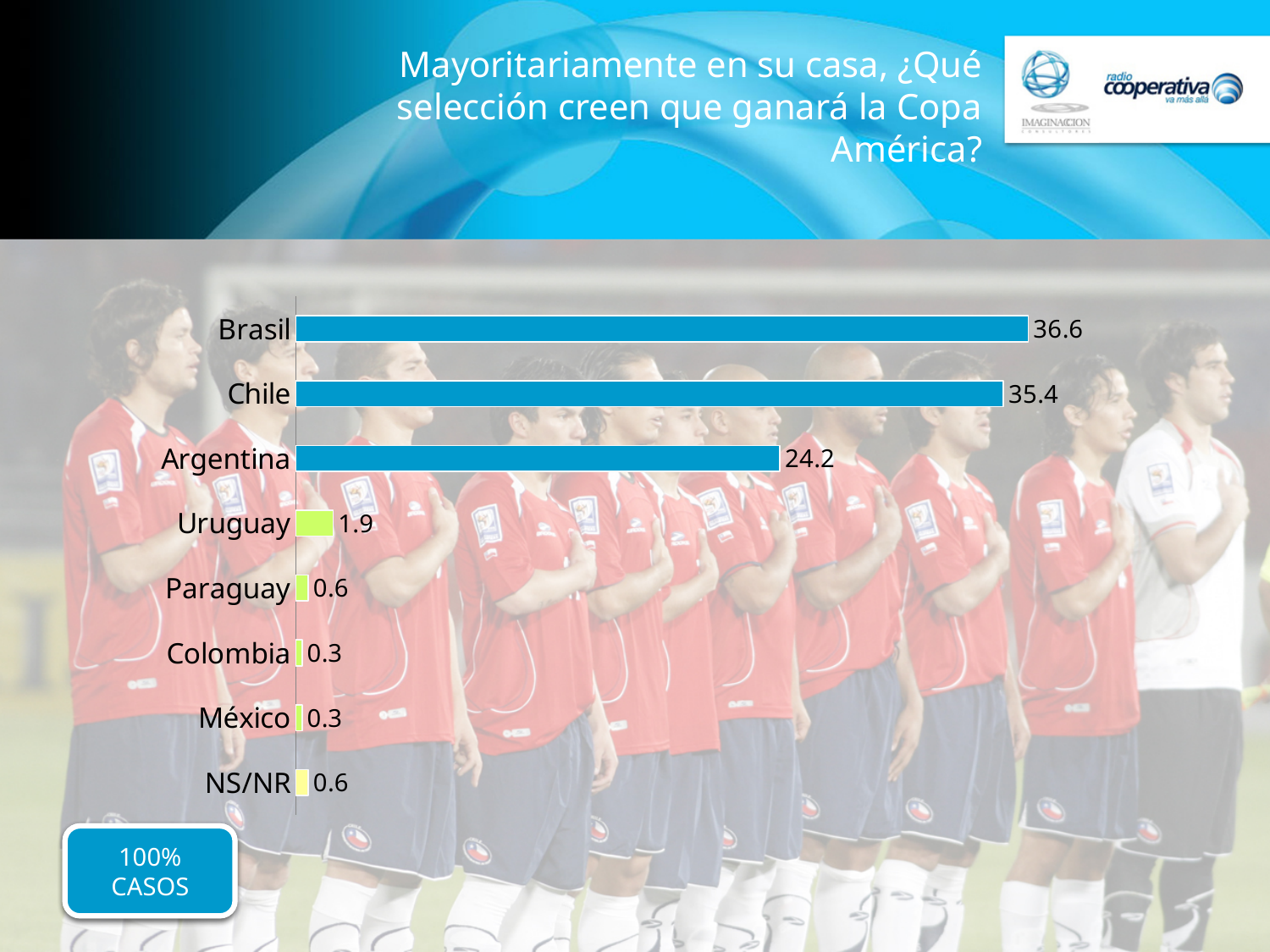
What is the difference between the values for Brasil and Chile? 1.2 What is the value for Paraguay? 0.6 What is the value for NS/NR? 0.6 Which is larger, the value for Argentina or the value for Uruguay? Argentina What kind of chart is shown on the slide? bar chart What is the value for Uruguay? 1.9 How many categories are shown in the chart? 8 What is the value for Brasil? 36.6 What is the value for Colombia? 0.3 What is the value for Argentina? 24.2 Which category has the highest value? Brasil What is the difference between the values for Chile and Argentina? 11.2